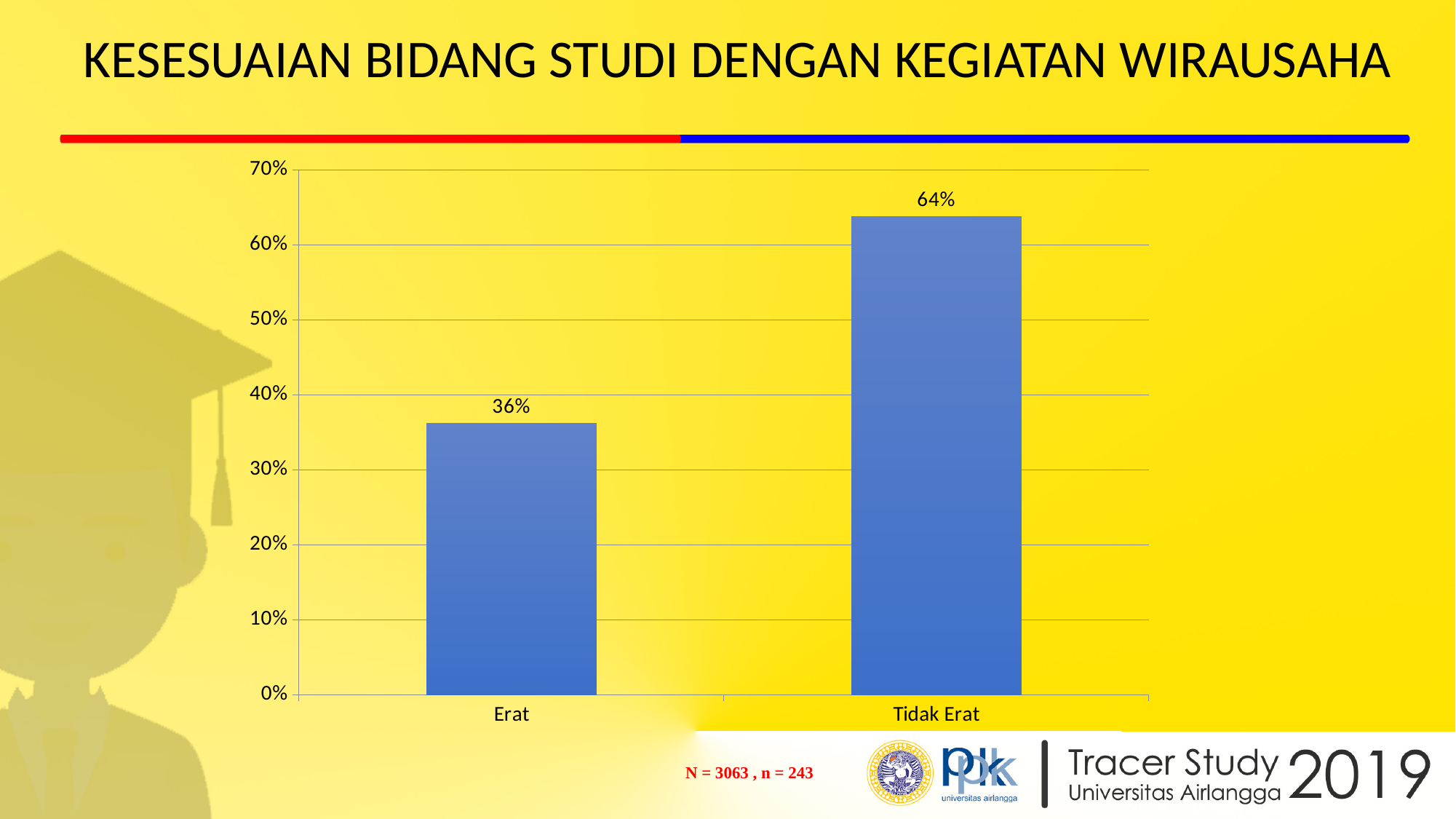
What is the value for Tidak Erat? 64% Which is larger, the value for Erat or the value for Tidak Erat? Tidak Erat What is the highest value shown on the y axis? 70% How many categories are shown on the x axis? 2 What is the title of the slide? KESESUAIAN BIDANG STUDI DENGAN KEGIATAN WIRAUSAHA What is the value for Erat? 36% Is the value for Tidak Erat greater or less than 60%? greater Is the value for Erat greater or less than 40%? less Which category has the lowest value? Erat What kind of chart is shown on the slide? bar chart What is the difference between the values for Tidak Erat and Erat? 28% Which category has the highest value? Tidak Erat